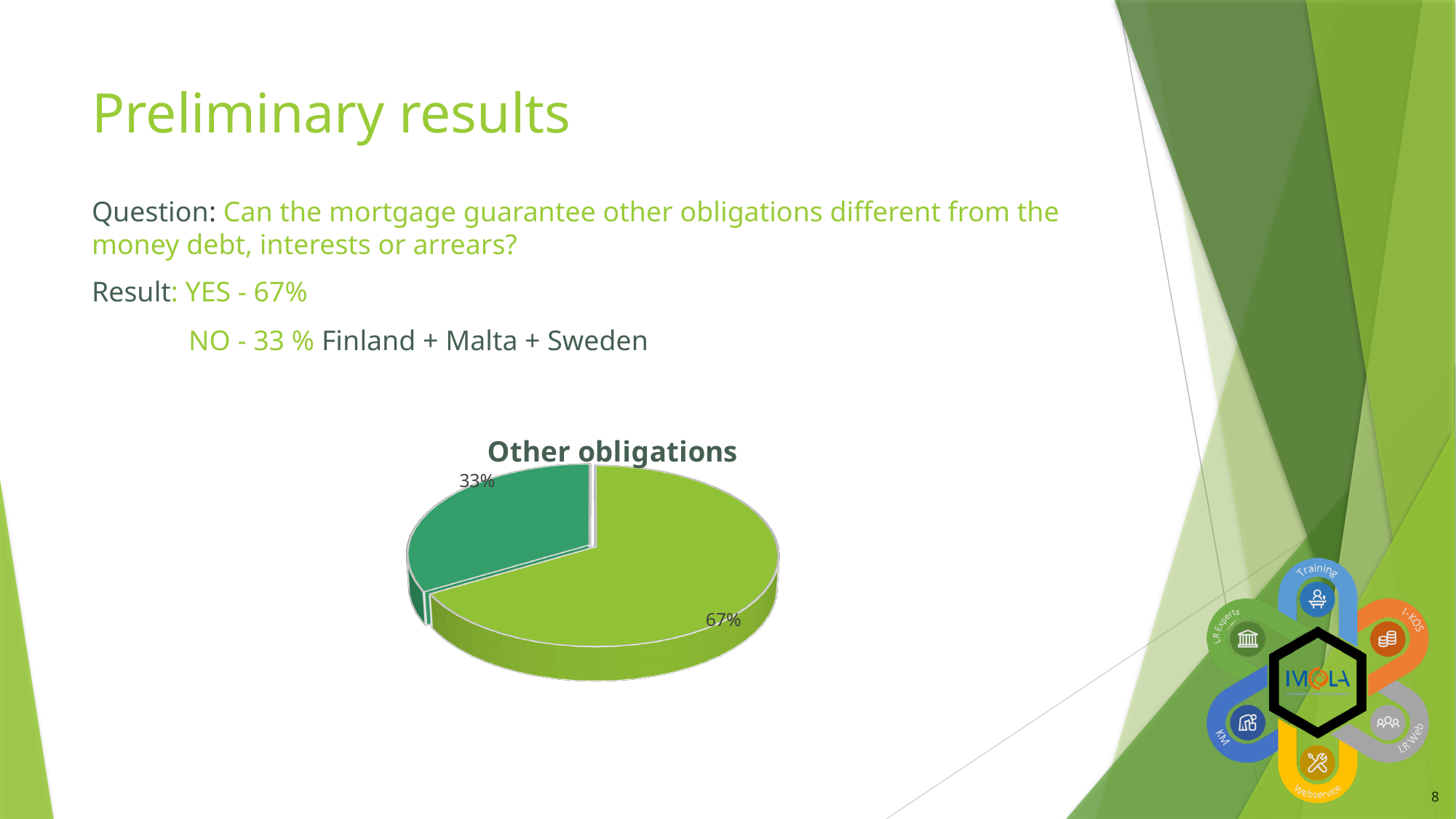
What is the title of the chart on the slide? Other obligations According to the slide, what share of the pie corresponds to the NO answer? 33% Which slice of the "Other obligations" pie chart is larger, the light green one or the teal one? the light green one According to the slide, what share of the pie corresponds to the YES answer? 67% How many slices does the "Other obligations" pie chart have? 2 What percentage is shown on the teal slice of the pie chart? 33% What is the value shown on the largest slice of the "Other obligations" pie chart? 67% What is the difference in percentage points between the two slices of the "Other obligations" pie chart? 34 What type of chart is shown under the title "Other obligations"? pie chart What is the value shown on the smallest slice of the "Other obligations" pie chart? 33% What percentage is shown on the light green slice of the pie chart? 67% Is the value of the teal slice in the "Other obligations" pie chart greater or less than 50%? less